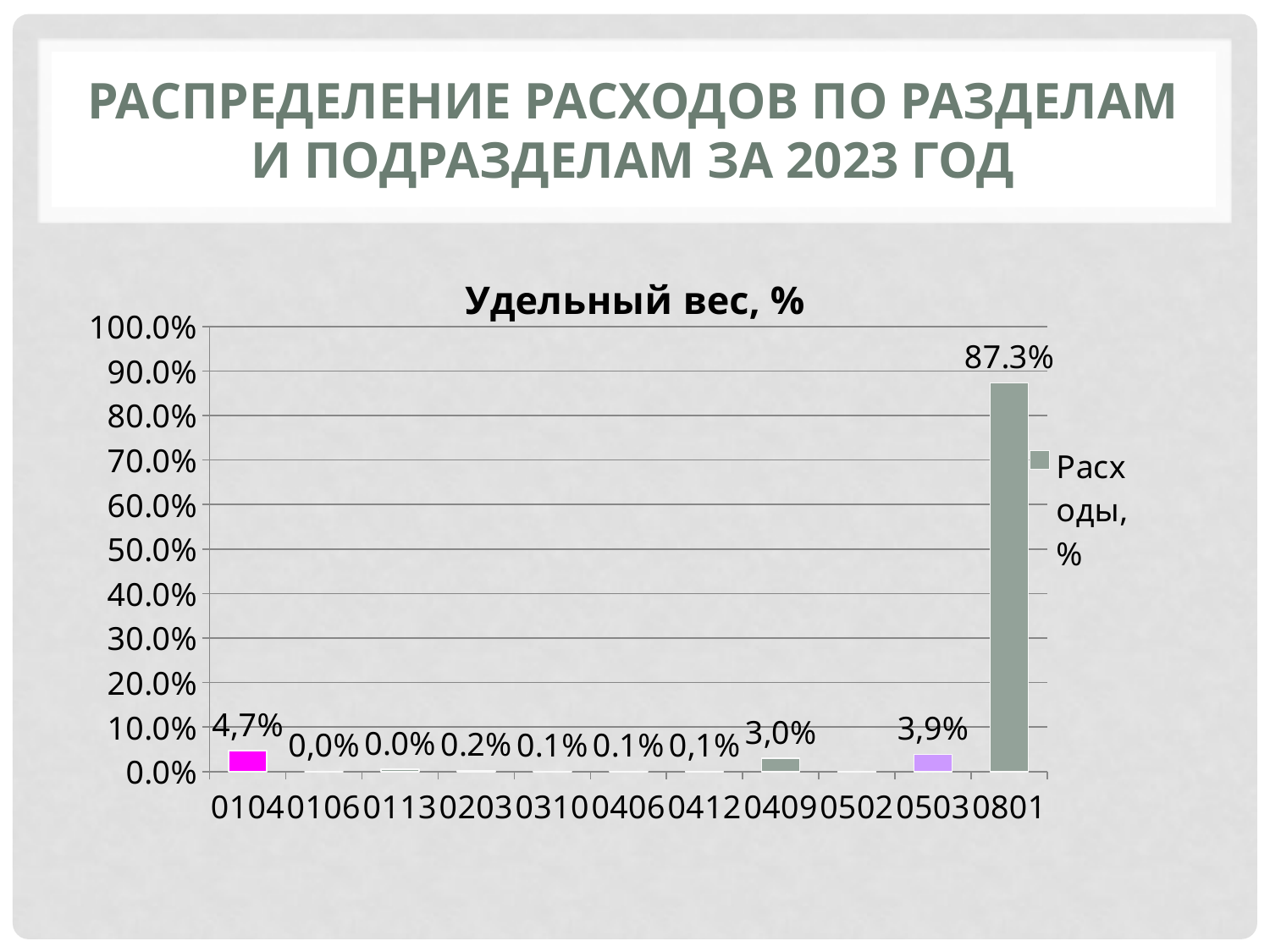
Which is larger, the value for 0104 or the value for 0503? 0104 How many series does the legend list? 1 What is the value for category 0801? 87.3% What is the value for category 0104? 4,7% Which category has the highest value? 0801 Is the value for 0801 greater or less than 80.0%? greater What is the value for category 0203? 0.2% What kind of chart is shown on the slide? bar chart What is the value for category 0409? 3,0% What is the difference between the values for 0801 and 0104? 82.6% What is the value for category 0503? 3,9% How many categories are shown on the x axis? 11